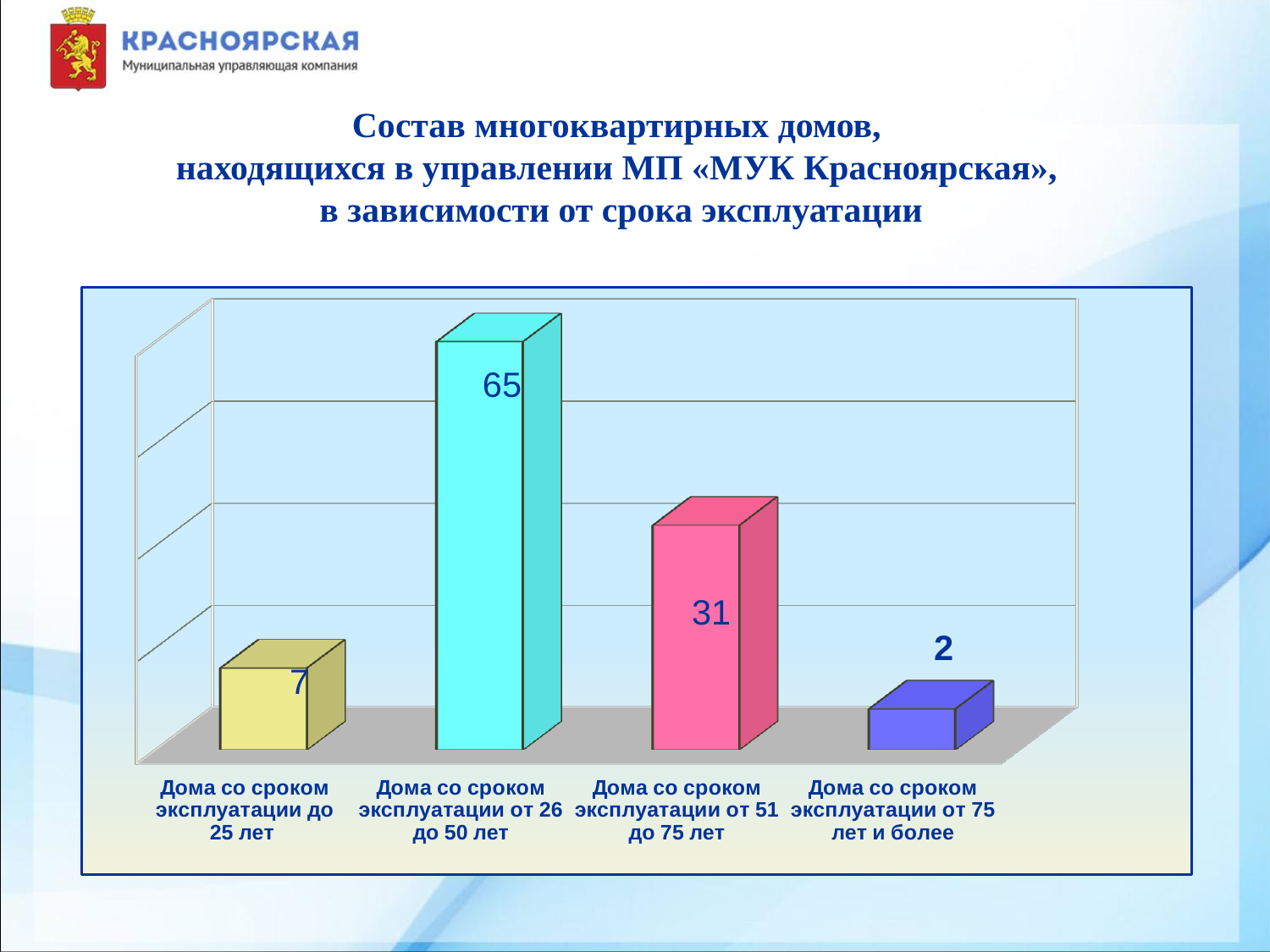
What is the difference between the values for houses aged up to 25 years and houses aged 75 years and more? 5 What is the difference between the values for houses aged 26 to 50 years and houses aged 51 to 75 years? 34 What is the value for houses with an operating period of 75 years and more? 2 How many categories are shown in the chart? 4 What is the total of all four values shown in the chart? 105 Which category has the lowest value? Дома со сроком эксплуатации от 75 лет и более What is the value for houses with an operating period from 26 to 50 years? 65 What is the value for houses with an operating period of up to 25 years (Дома со сроком эксплуатации до 25 лет)? 7 Which category has the highest value? Дома со сроком эксплуатации от 26 до 50 лет What is the value for houses with an operating period from 51 to 75 years? 31 What kind of chart is shown on the slide? Bar chart Which is larger: the value for houses aged up to 25 years or the value for houses aged 51 to 75 years? Дома со сроком эксплуатации от 51 до 75 лет